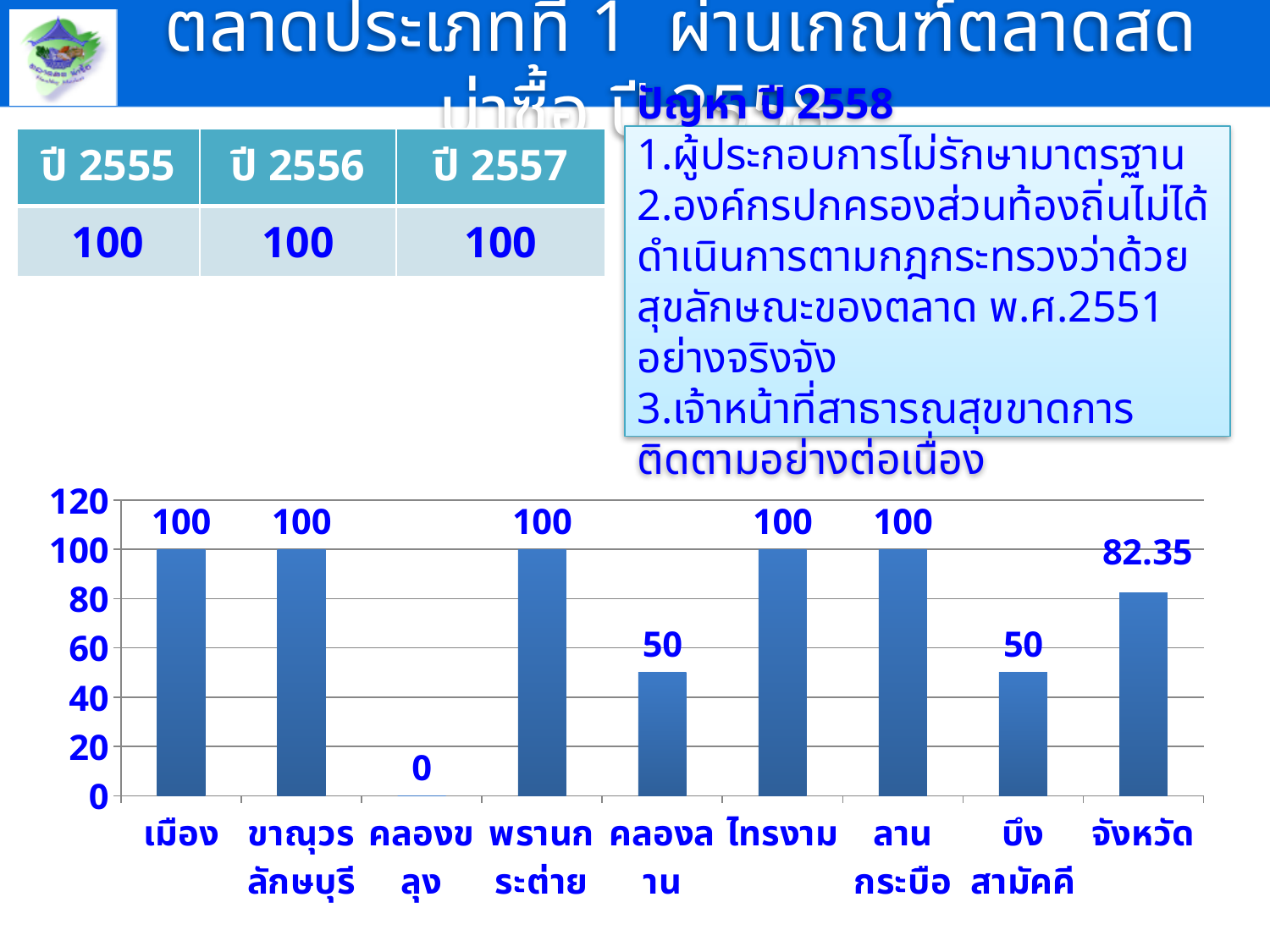
Is the value for จังหวัด greater or less than 80? greater What is the difference between the values for ลานกระบือ and จังหวัด? 17.65 What is the value for คลองขลุง in the bar chart? 0 How many categories in the bar chart have a value of 100? 5 How many categories are shown on the x axis of the bar chart? 9 Which category has the lowest value in the bar chart? คลองขลุง What is the value for เมือง in the bar chart? 100 What kind of chart is shown on the slide? bar chart What is the value for คลองลาน in the bar chart? 50 Which is larger, the value for จังหวัด or the value for คลองลาน? จังหวัด What is the difference between the values for ไทรงาม and บึงสามัคคี? 50 What is the value for จังหวัด in the bar chart? 82.35